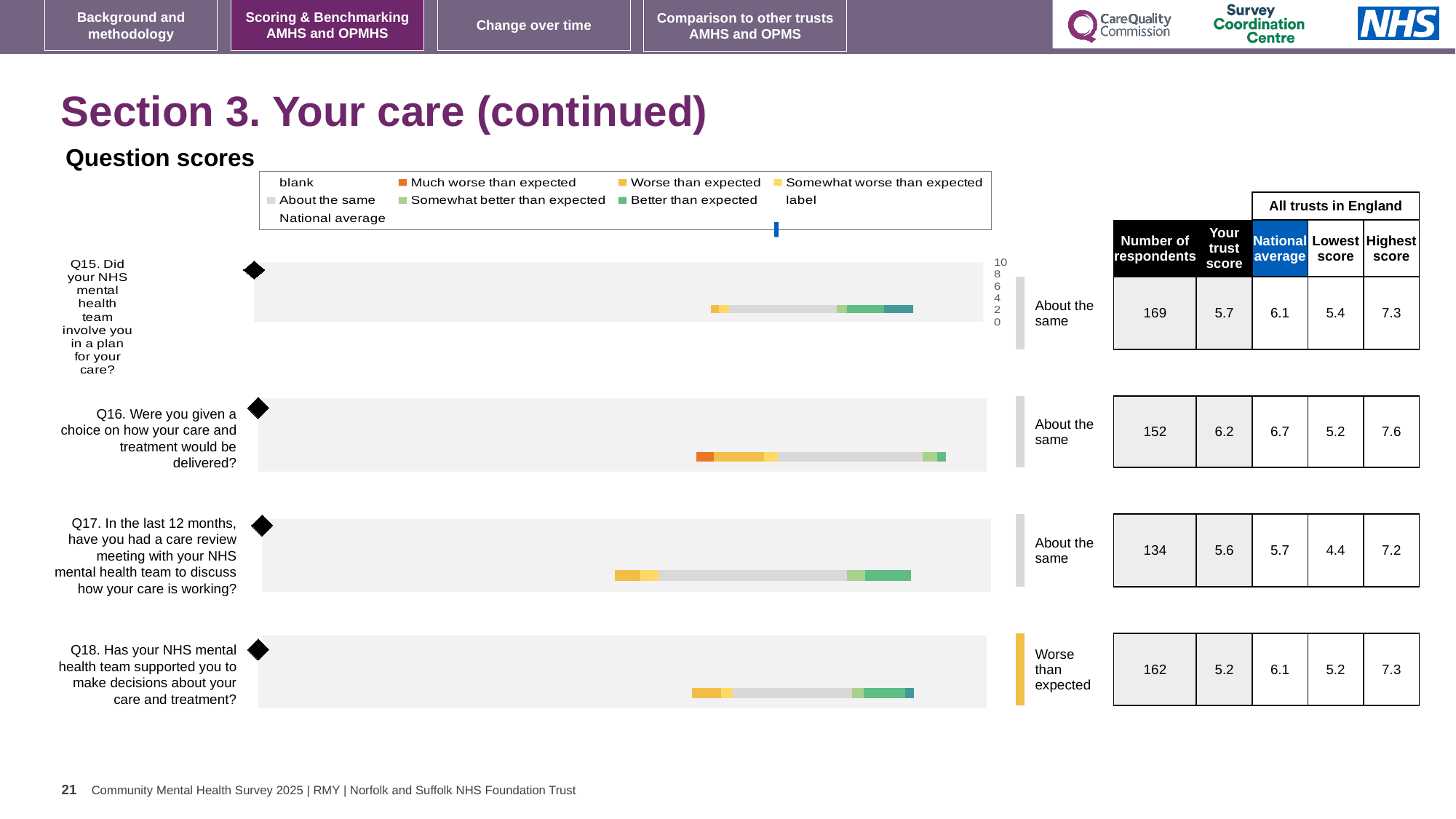
What is the national average score for Q16 (Were you given a choice on how your care and treatment would be delivered?)? 6.7 What is the lowest score among all trusts in England for Q17? 4.4 What benchmark label is shown next to the bar for Q18? Worse than expected How many survey questions (bars) are plotted in the question scores chart? 4 What is the 'Your trust score' for Q15 (Did your NHS mental health team involve you in a plan for your care?)? 5.7 Which question has the lowest 'Your trust score'? Q18 How many respondents answered Q18 (Has your NHS mental health team supported you to make decisions about your care and treatment?)? 162 For Q18, which is larger: the trust score or the national average? the national average What is the difference between the highest score and the lowest score for Q16? 2.4 What benchmark label is shown next to the bar for Q16? About the same What kind of chart is used to show the question scores on this slide? bar chart Which question has the highest number of respondents? Q15